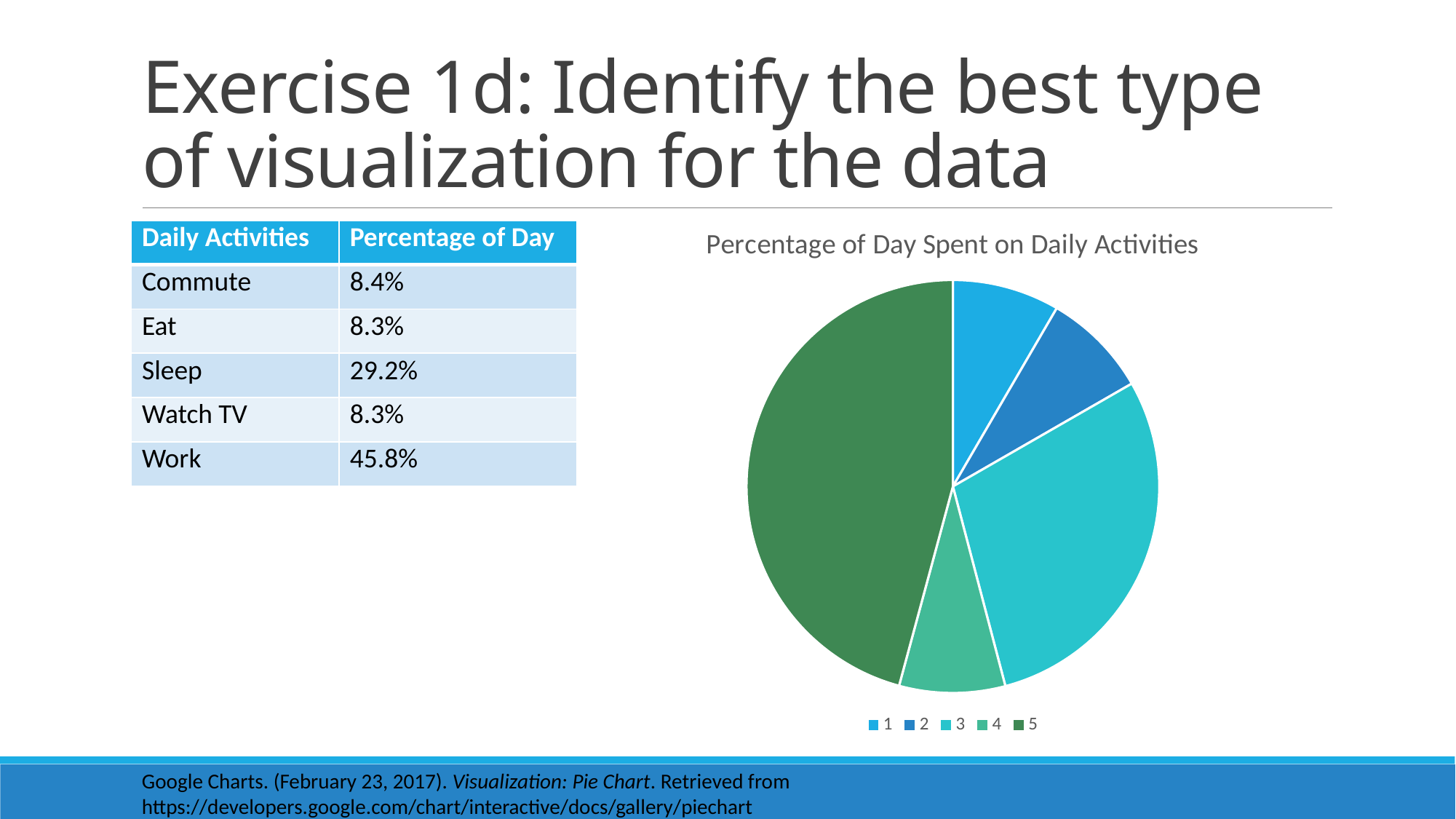
What is the title of the pie chart? Percentage of Day Spent on Daily Activities Which is larger in the pie chart, slice 2 or slice 5? 5 Which is larger in the pie chart, slice 1 or slice 3? 3 Which is larger in the pie chart, slice 4 or slice 3? 3 How many entries does the pie chart's legend list? 5 How many slices does the pie chart have? 5 What colour is slice 5 in the pie chart? dark green Which slice of the pie chart is the largest? 5 What kind of chart is shown on the slide? pie chart